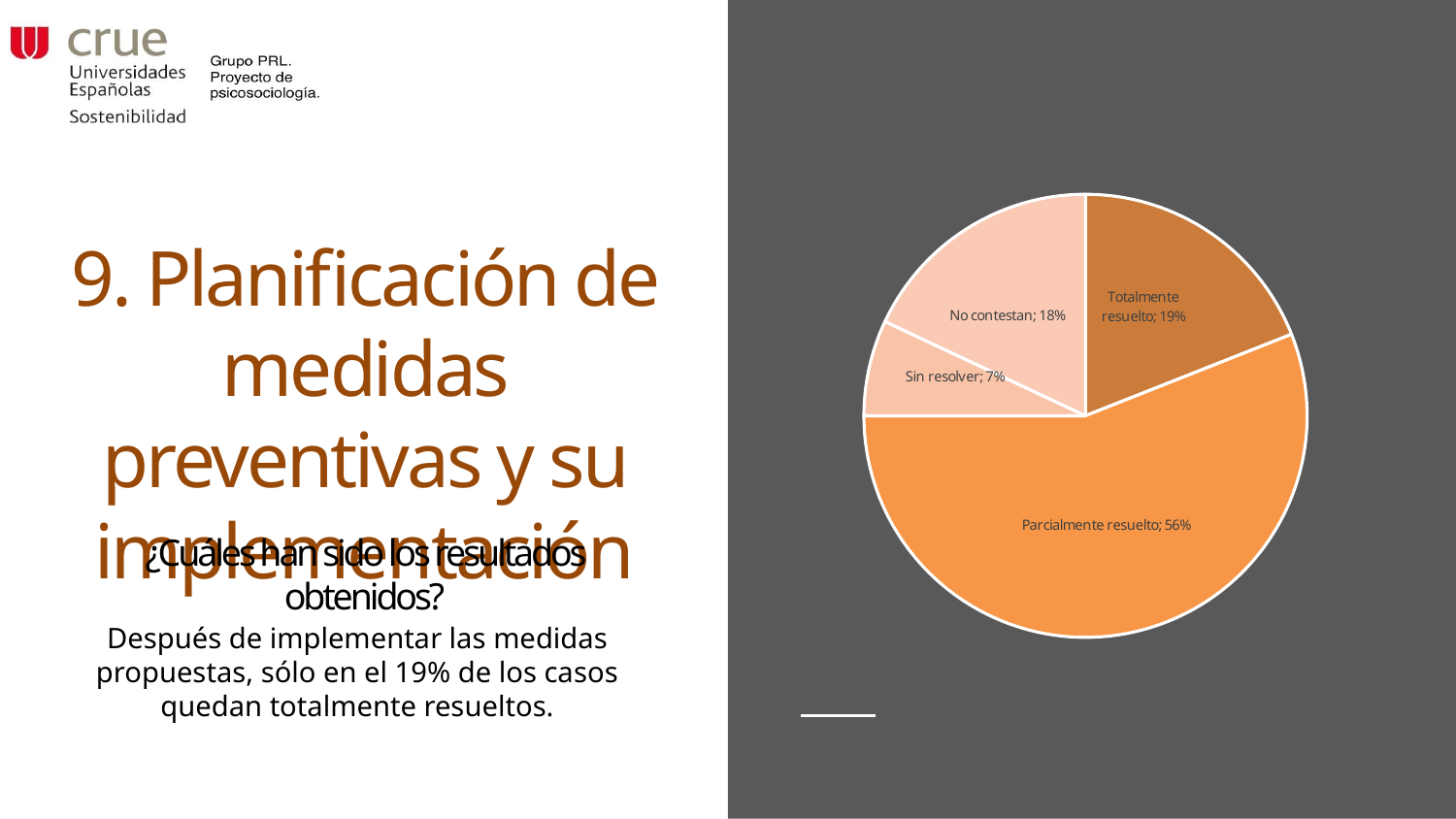
What is the difference between the "Parcialmente resuelto" and "Totalmente resuelto" values? 37 percentage points What is the value for "Sin resolver" in the pie chart? 7% What is the value for "No contestan" in the pie chart? 18% How many slices does the pie chart have? 4 Which is larger, "Totalmente resuelto" or "Sin resolver"? Totalmente resuelto What kind of chart is shown on the slide? pie chart Which category has the smallest slice in the pie chart? Sin resolver What is the combined value of "Totalmente resuelto" and "Parcialmente resuelto"? 75% Which category has the largest slice in the pie chart? Parcialmente resuelto What share of the pie does "Parcialmente resuelto" represent? 56% What is the value for "Parcialmente resuelto" in the pie chart? 56% What is the value for "Totalmente resuelto" in the pie chart? 19%